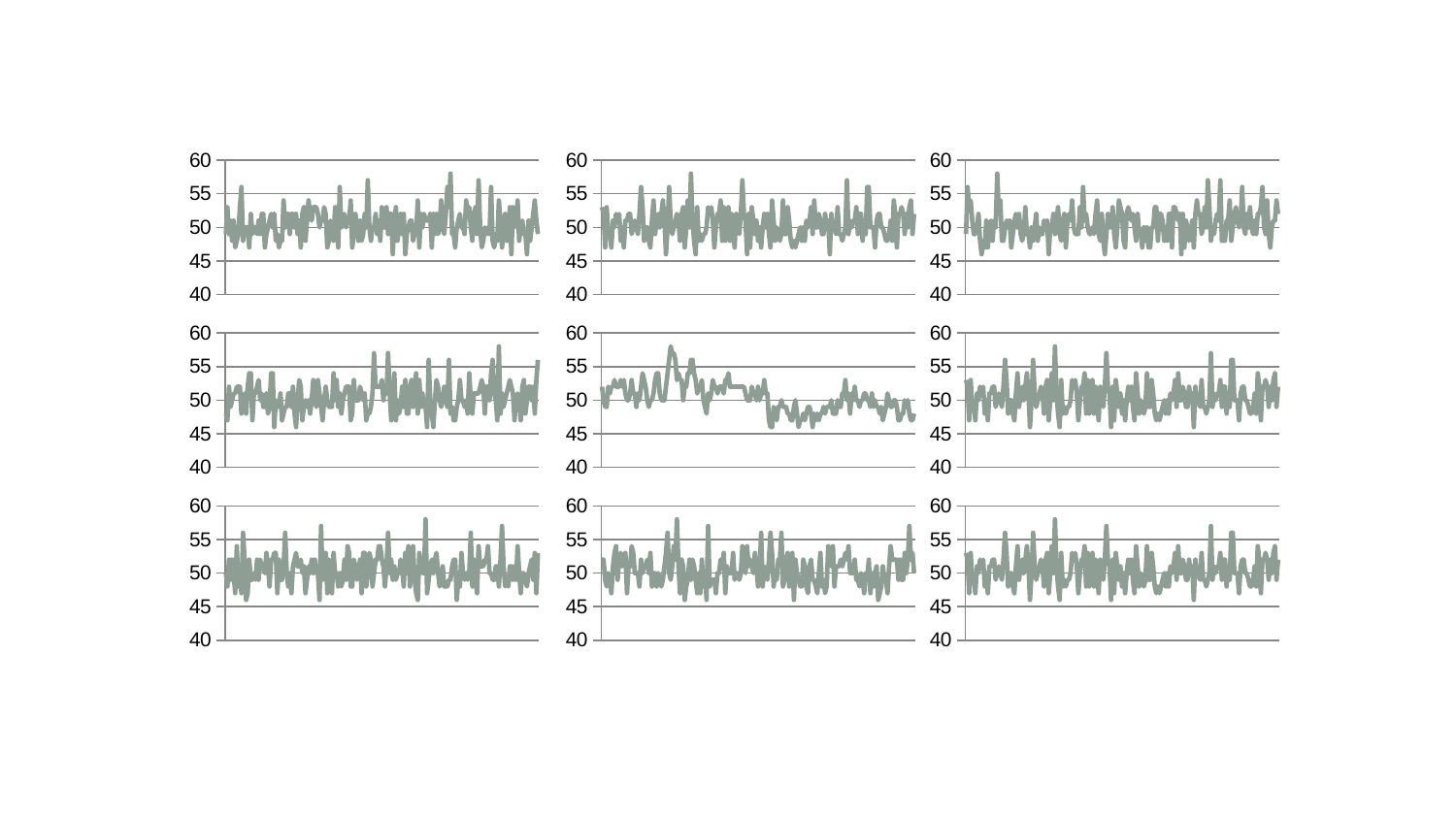
In the top-left chart, is the lowest point greater or less than 40? greater How many charts are shown on the slide? 9 What is the lowest tick value on the y axis of the bottom-right chart? 40 In the bottom-left chart, is the highest point greater or less than 55? greater What kind of chart is shown in the top-left position on the slide? line chart In the center chart (middle row, middle column), is the lowest value greater or less than 50? less What is the highest tick value on the y axis of the top-left chart? 60 In the center chart (middle row, middle column), do the values generally rise or fall from left to right along the x axis? fall